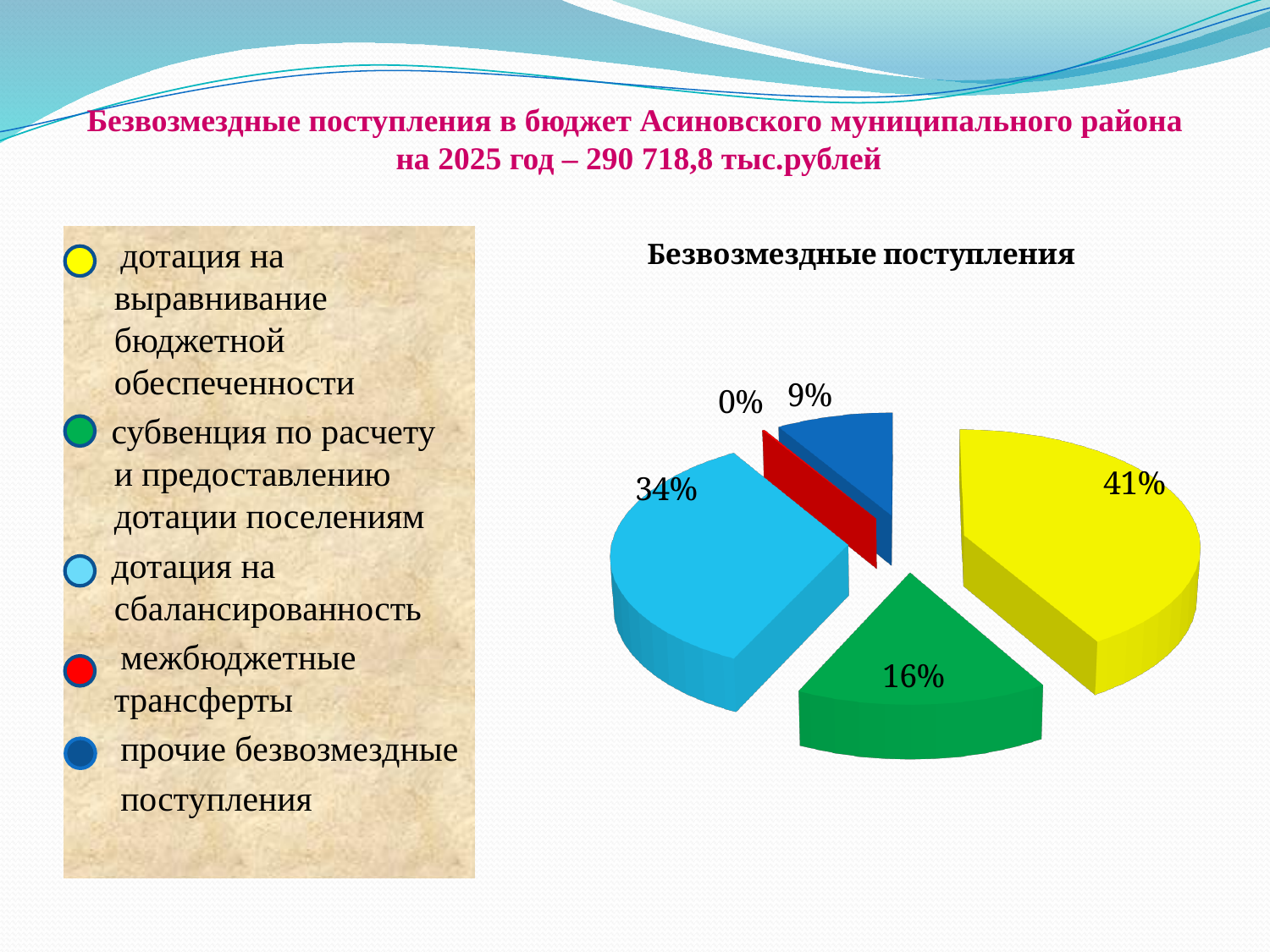
Which category has the smallest share of the pie? межбюджетные трансферты What share of the pie does the dark blue slice (прочие безвозмездные поступления) represent? 9% What is the title of the chart? Безвозмездные поступления Which is larger: the share for субвенция по расчету и предоставлению дотации поселениям or the share for прочие безвозмездные поступления? субвенция по расчету и предоставлению дотации поселениям What is the difference in percentage points between the yellow slice (41%) and the light blue slice (34%)? 7 What share of the pie does the light blue slice (дотация на сбалансированность) represent? 34% Which category has the largest share of the pie? дотация на выравнивание бюджетной обеспеченности What share of the pie does the green slice (субвенция по расчету и предоставлению дотации поселениям) represent? 16% What kind of chart is shown on the slide? pie chart What share of the pie does the red slice (межбюджетные трансферты) represent? 0% How many slices does the pie chart have? 5 What share of the pie does the yellow slice (дотация на выравнивание бюджетной обеспеченности) represent? 41%